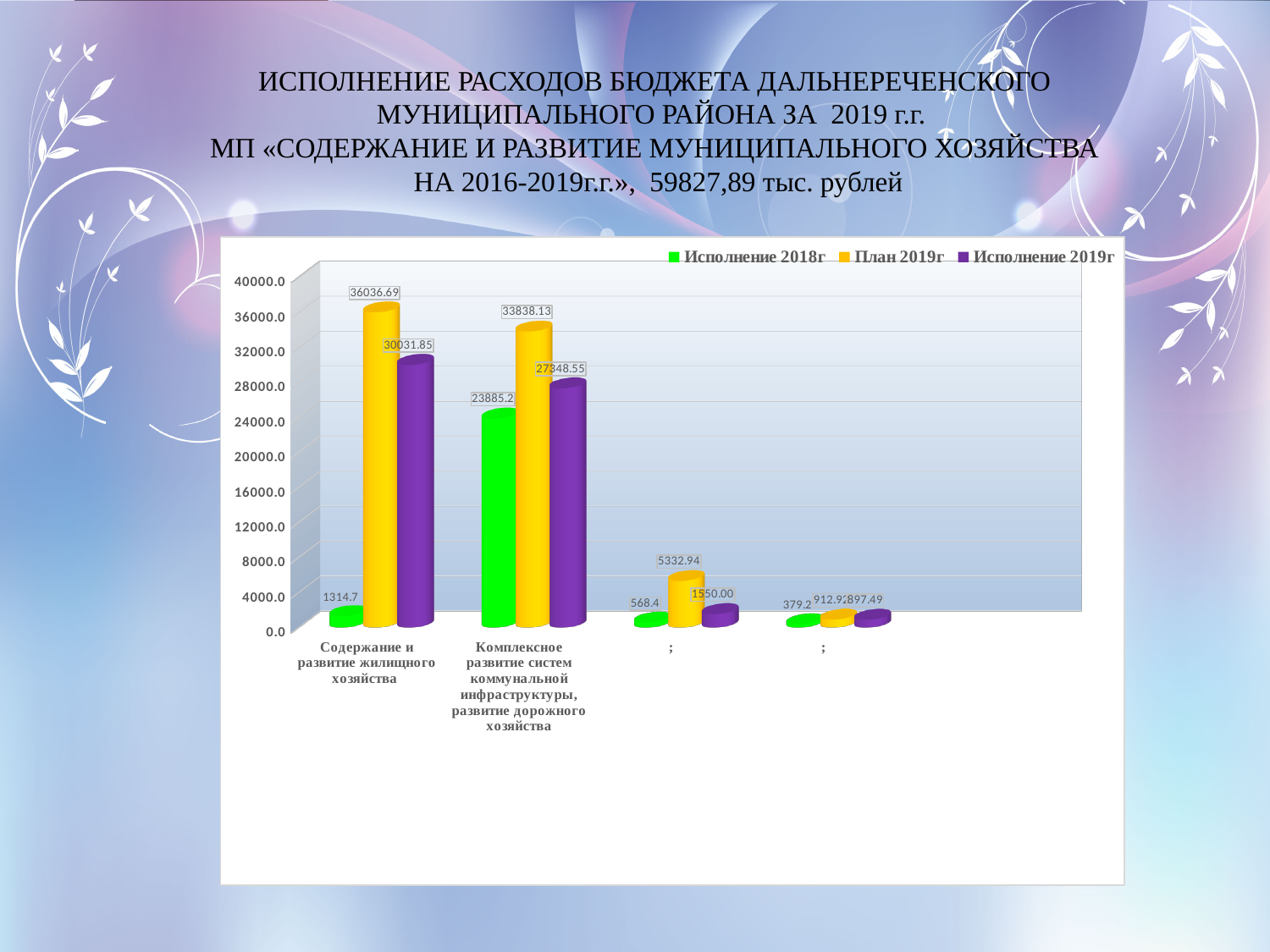
What is the difference between План 2019г and Исполнение 2019г for the category Содержание и развитие жилищного хозяйства? 6004.84 What kind of chart is shown on the slide? Bar chart What is the value of Исполнение 2018г for the category Комплексное развитие систем коммунальной инфраструктуры, развитие дорожного хозяйства? 23885.2 How many series does the legend list? 3 What is the value of Исполнение 2018г for the category Содержание и развитие жилищного хозяйства? 1314.7 What is the value of План 2019г for the category Комплексное развитие систем коммунальной инфраструктуры, развитие дорожного хозяйства? 33838.13 What is the value of План 2019г for the category Содержание и развитие жилищного хозяйства? 36036.69 Which category has the highest value for the series План 2019г? Содержание и развитие жилищного хозяйства What is the difference between План 2019г and Исполнение 2019г for the category Комплексное развитие систем коммунальной инфраструктуры, развитие дорожного хозяйства? 6489.58 Which colour represents the series План 2019г in the legend? Yellow Which is larger for the category Комплексное развитие систем коммунальной инфраструктуры, развитие дорожного хозяйства: Исполнение 2018г or Исполнение 2019г? Исполнение 2019г What is the value of Исполнение 2019г for the category Содержание и развитие жилищного хозяйства? 30031.85